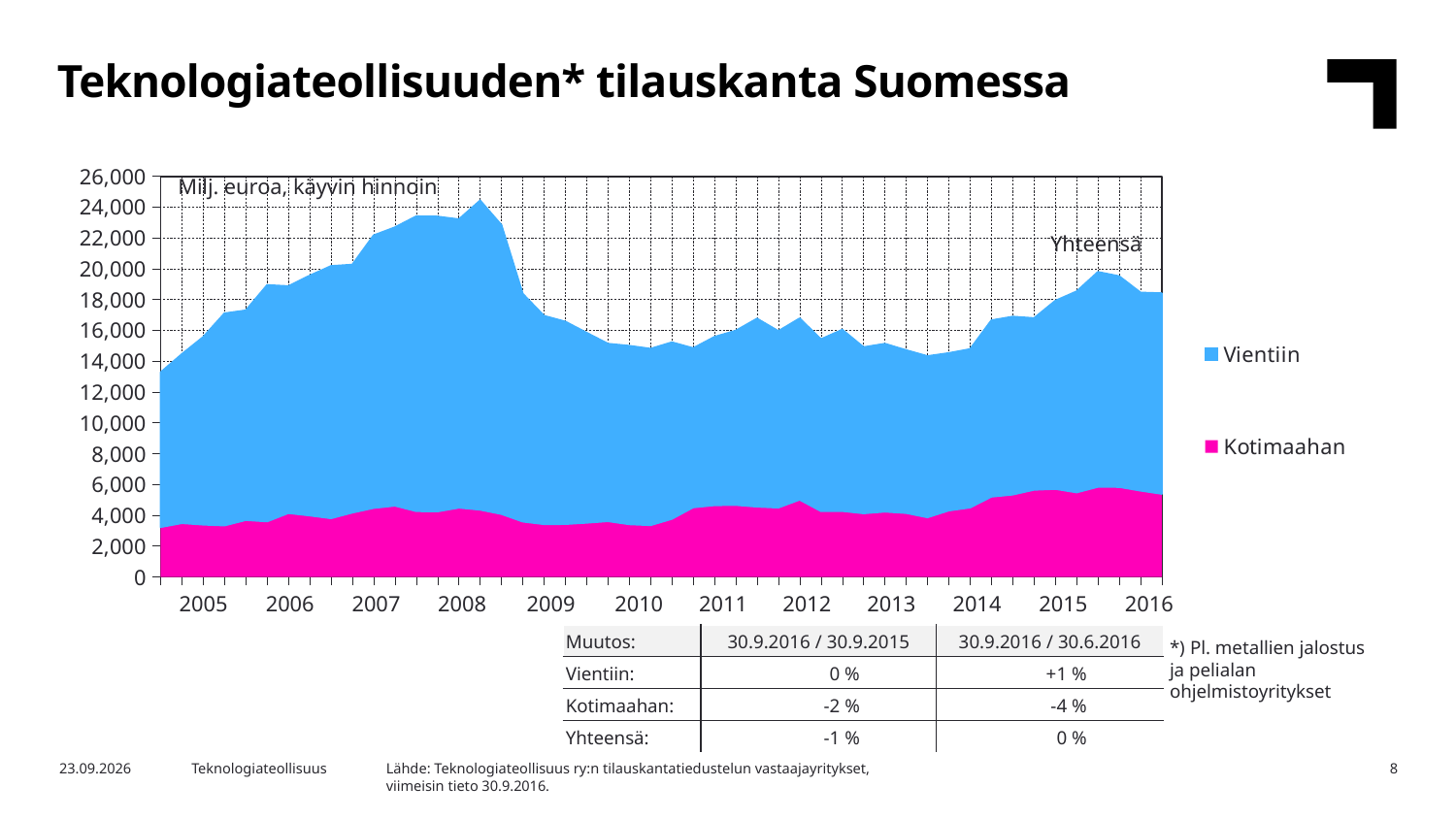
In which year does the total (Yhteensä) order book reach its highest level? 2008 How many series does the chart legend list? 2 Which series is larger throughout the chart, Vientiin or Kotimaahan? Vientiin Is the Kotimaahan value in 2015 greater or less than 4,000? greater What unit is stated for the values in the chart? Milj. euroa, käyvin hinnoin Is the total value in 2016 greater or less than 16,000? greater Does the total order book rise or fall between 2008 and 2009? fall Is the peak total value in 2008 greater or less than 22,000? greater What kind of chart is shown on the slide? Area chart What are the two series named in the chart legend? Vientiin and Kotimaahan How many years are labelled on the x axis of the chart? 12